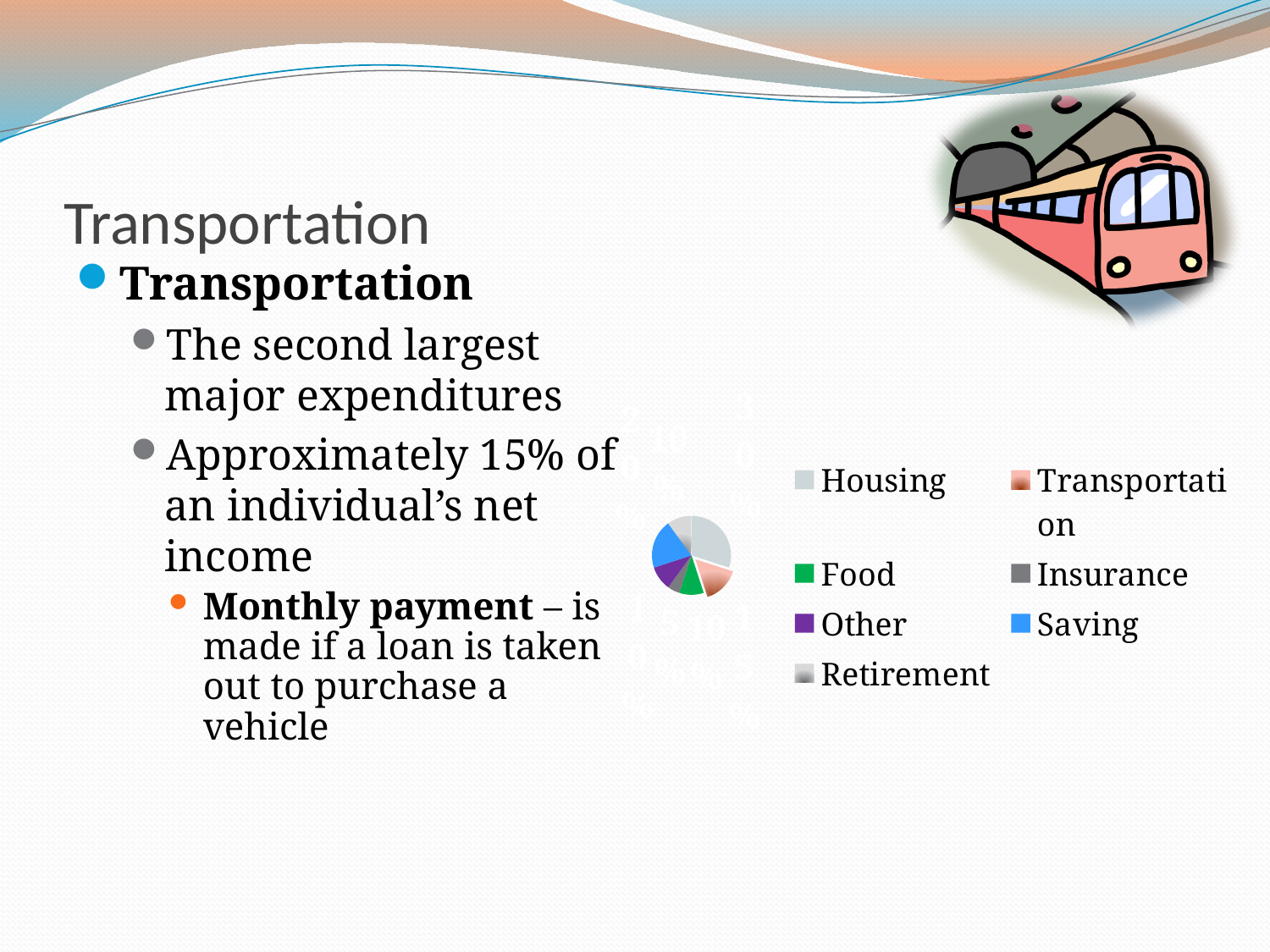
Which slice is larger in the pie chart, Housing or Food? Housing Which slice is larger in the pie chart, Housing or Retirement? Housing Which category has the largest slice in the pie chart? Housing Which category is shown in blue in the pie chart's legend? Saving What kind of chart is shown on the slide? pie chart How many categories does the pie chart's legend list? 7 Which category is shown in green in the pie chart's legend? Food